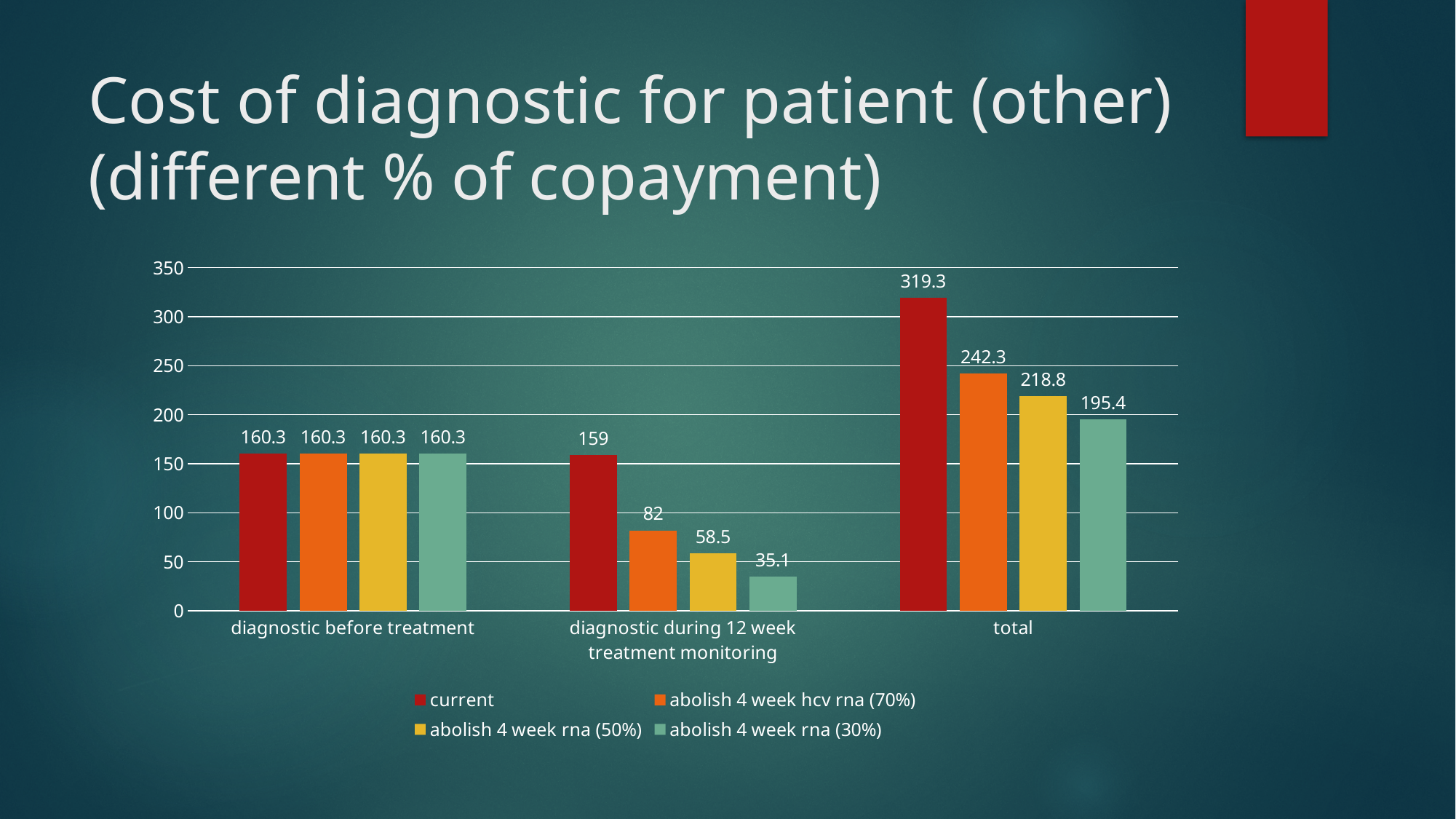
What is the value for 'abolish 4 week rna (50%)' in the 'diagnostic before treatment' category? 160.3 What is the value for 'abolish 4 week rna (50%)' in the 'diagnostic during 12 week treatment monitoring' category? 58.5 How many series does the legend list? 4 How many categories are shown on the x axis? 3 Which series has the highest value in the 'total' category? current What is the value for 'abolish 4 week rna (30%)' in the 'diagnostic during 12 week treatment monitoring' category? 35.1 What kind of chart is shown on the slide? bar chart What is the value for 'abolish 4 week hcv rna (70%)' in the 'total' category? 242.3 What is the value for 'current' in the 'total' category? 319.3 What is the difference between the 'current' and 'abolish 4 week rna (30%)' values in the 'total' category? 123.9 Which series has the lowest value in the 'diagnostic during 12 week treatment monitoring' category? abolish 4 week rna (30%) Which is larger in the 'diagnostic during 12 week treatment monitoring' category: 'current' or 'abolish 4 week hcv rna (70%)'? current